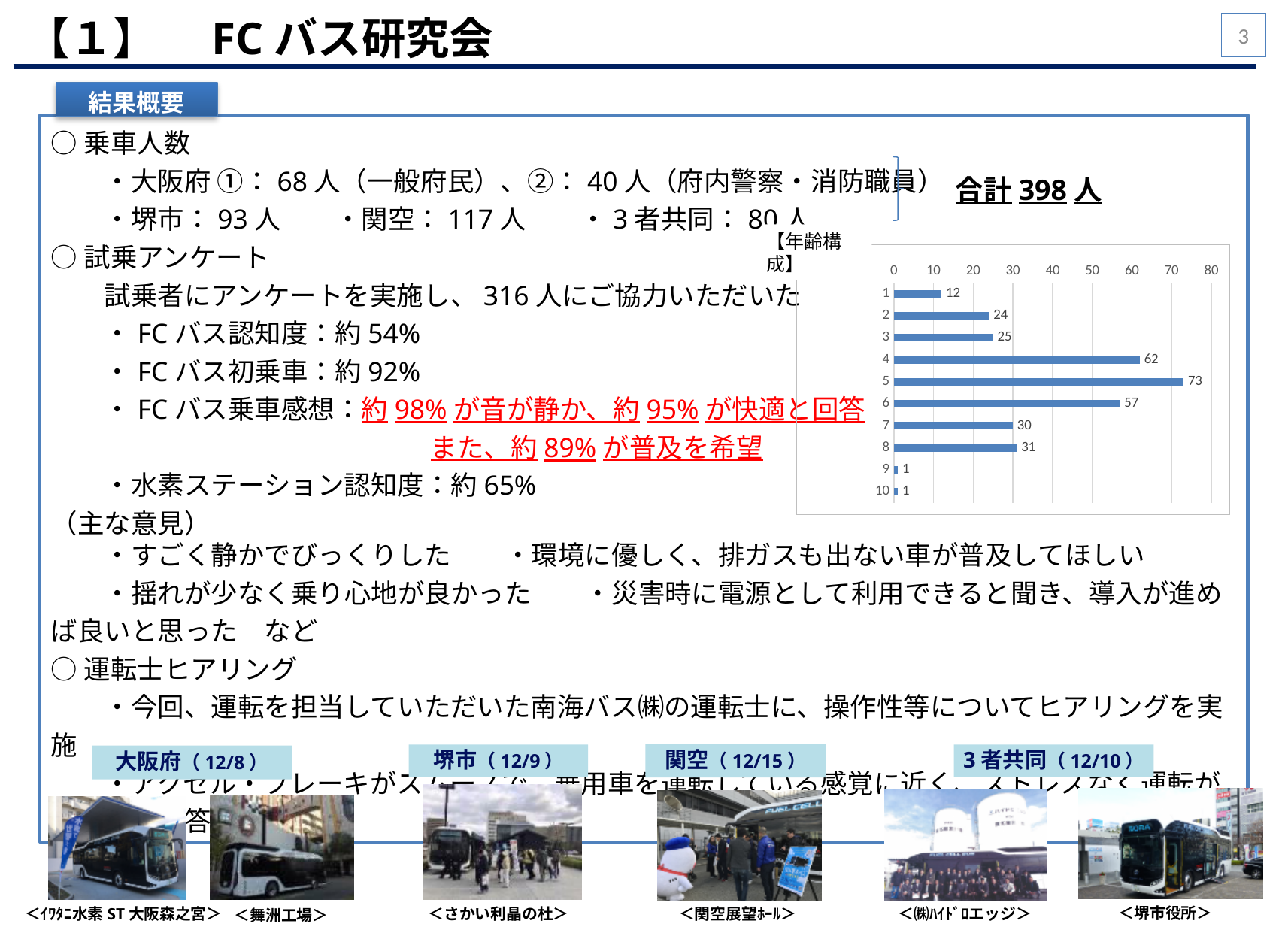
Which is larger in the 年齢構成 chart, the value for category 6 or the value for category 7? category 6 Is the value for category 6 in the 年齢構成 chart greater or less than 50? greater What is the value for category 1 in the 年齢構成 chart? 12 What is the value for category 5 in the 年齢構成 chart? 73 What is the value for category 4 in the 年齢構成 chart? 62 What is the title of the chart on the slide? 【年齢構成】 What is the difference between the values for category 3 and category 2 in the 年齢構成 chart? 1 What kind of chart is shown on the slide? bar chart What is the difference between the values for category 5 and category 4 in the 年齢構成 chart? 11 How many categories are plotted in the 年齢構成 chart? 10 Which category has the highest value in the 年齢構成 chart? 5 What is the value for category 8 in the 年齢構成 chart? 31